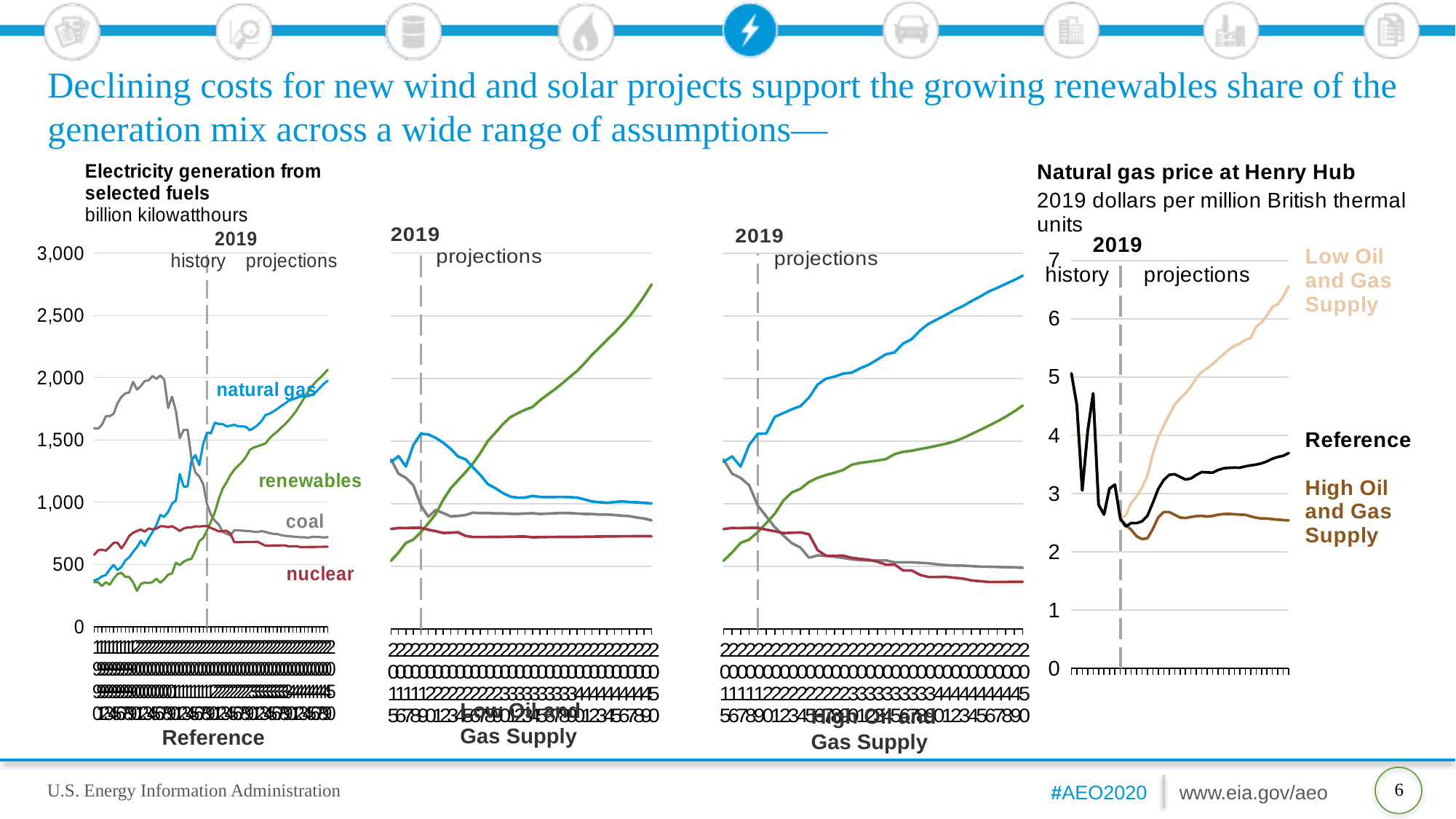
In the Natural gas price at Henry Hub chart, is the High Oil and Gas Supply price at the end of the projection period greater or less than 3? less How many fuel series are labelled on the Reference electricity generation chart? 4 In the Reference electricity generation chart, is natural gas generation at the end of the projection period greater or less than 1,500? greater In the Low Oil and Gas Supply electricity generation chart, is renewables generation at the end of the projection period greater or less than 2,500? greater In the Reference electricity generation chart, does coal generation rise or fall over the projection period? fall What unit is used for the electricity generation charts? billion kilowatthours What kind of chart is the Reference electricity generation chart? line chart In the Low Oil and Gas Supply electricity generation chart, which fuel has the highest generation at the end of the projection period? renewables How many series are labelled on the Natural gas price at Henry Hub chart? 3 In the High Oil and Gas Supply electricity generation chart, does natural gas generation rise or fall over the projection period? rise In the Natural gas price at Henry Hub chart, which is higher at the end of the projection period, Low Oil and Gas Supply or High Oil and Gas Supply? Low Oil and Gas Supply